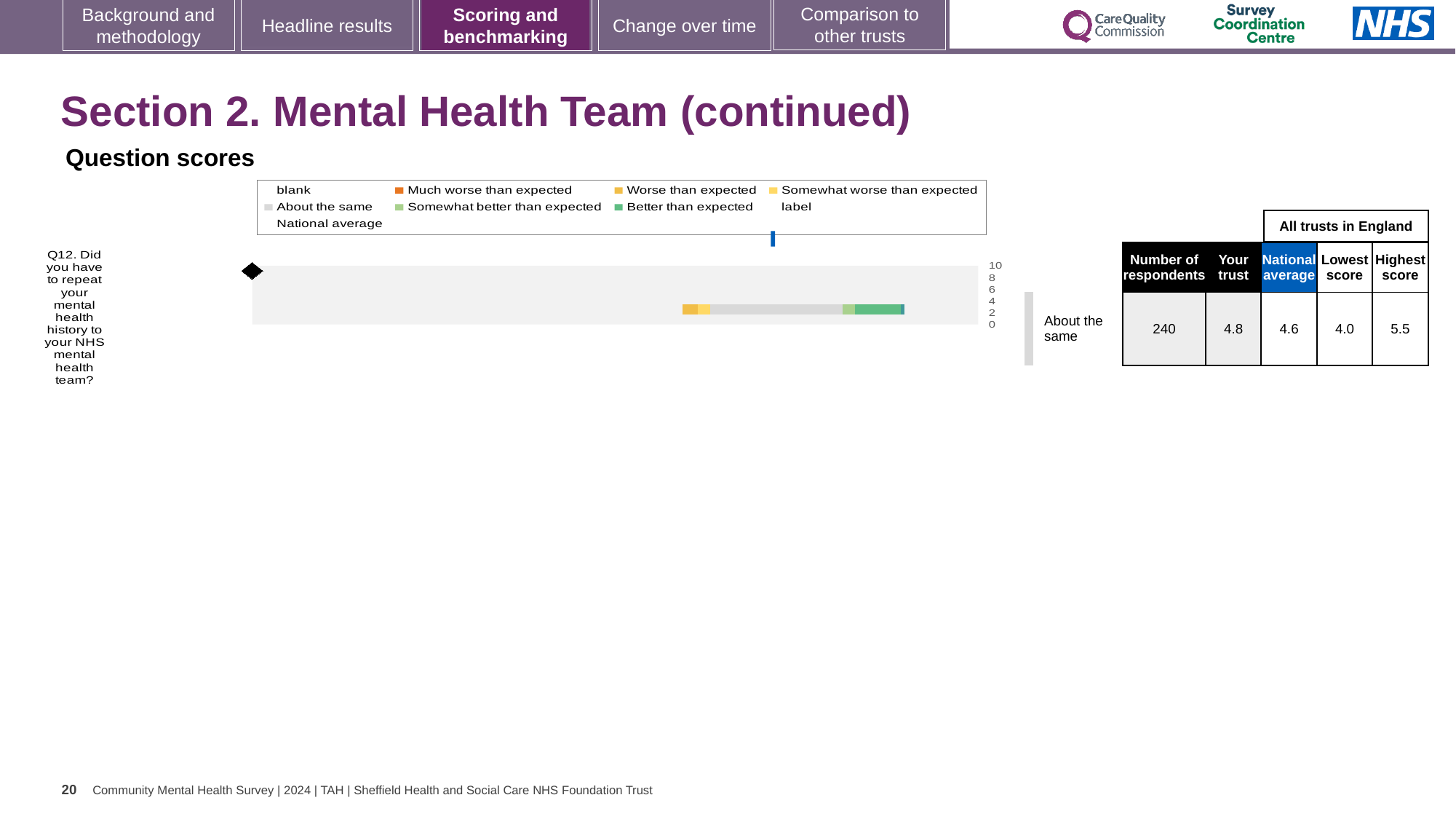
How many survey questions are plotted on the chart? 1 Which question is plotted on the chart? Q12. Did you have to repeat your mental health history to your NHS mental health team? Which is higher for Q12, the 'Your trust' score or the national average? Your trust What benchmark category is shown for Q12 next to the chart? About the same What is the lowest score among all trusts in England for Q12? 4.0 What is the highest score among all trusts in England for Q12? 5.5 What is the difference between the highest score and the lowest score for Q12? 1.5 By how much does the 'Your trust' score for Q12 exceed the national average? 0.2 What is the 'Your trust' score for Q12? 4.8 How many respondents answered Q12? 240 What kind of chart is used to show the Q12 question score? bar chart What is the national average score for Q12? 4.6